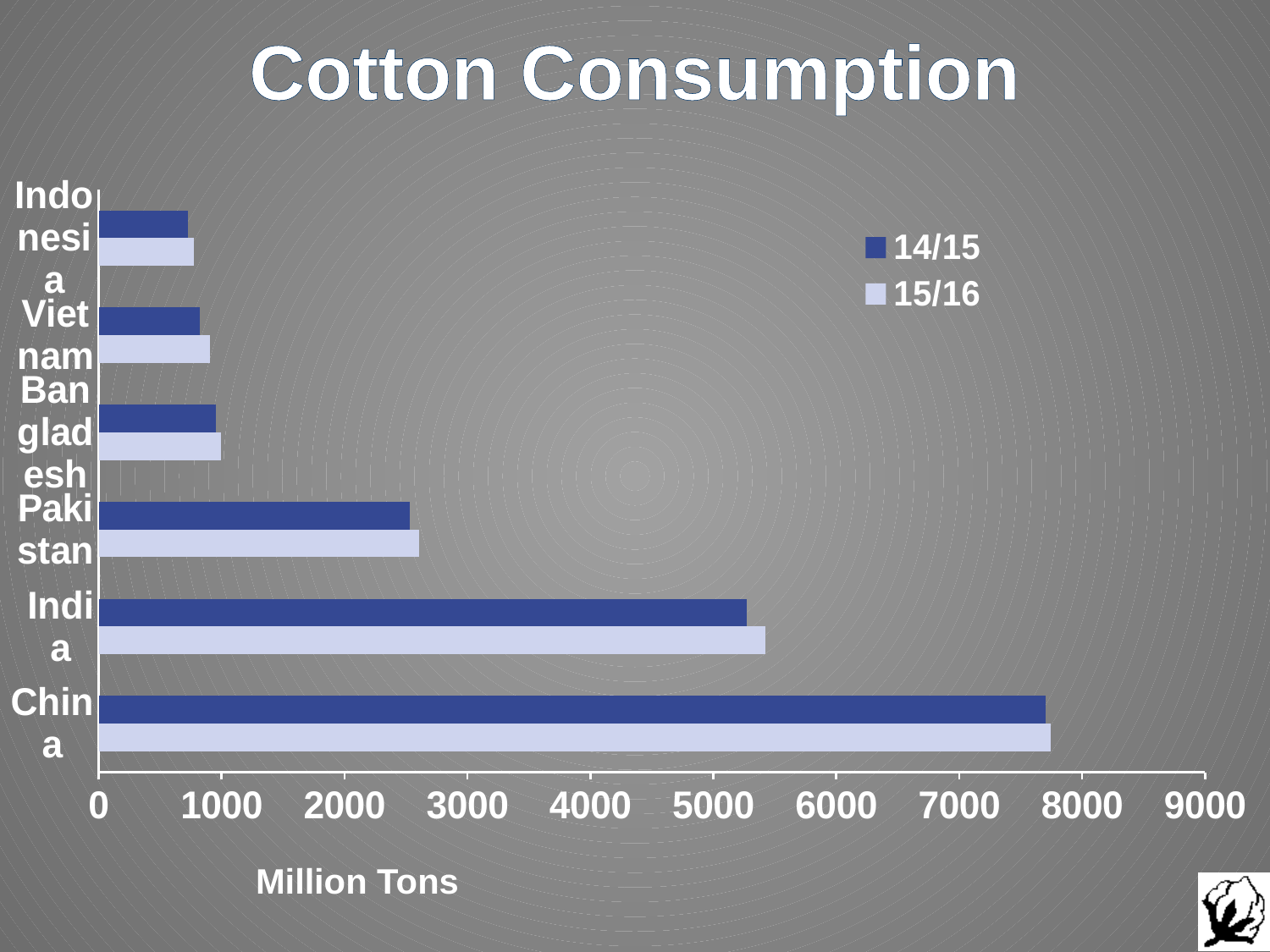
How many countries are shown on the chart? 6 How many series does the legend list? 2 Is the 15/16 value for India greater or less than 5000? greater Is the 14/15 value for Pakistan greater or less than 3000? less What kind of chart is shown on the slide? bar chart Is the 14/15 value for China greater or less than 7000? greater Which is larger, the 14/15 value for India or the 14/15 value for Pakistan? India What is the title of the chart? Cotton Consumption What unit label is shown below the horizontal axis? Million Tons Which country has the lowest cotton consumption in 14/15? Indonesia Which country has the highest cotton consumption in 15/16? China